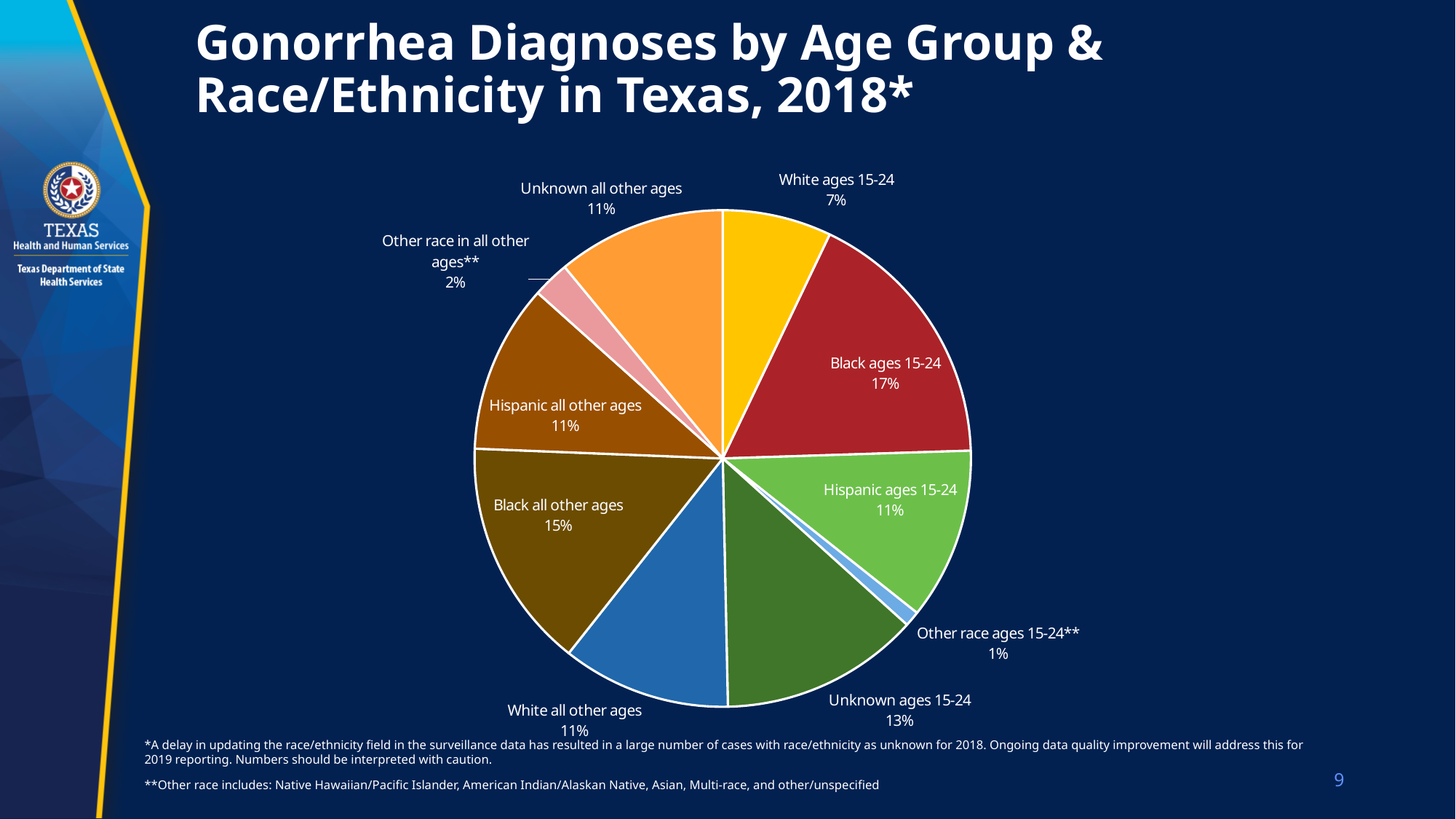
What is the title of the chart on the slide? Gonorrhea Diagnoses by Age Group & Race/Ethnicity in Texas, 2018* Which category has the smallest share of the pie? Other race ages 15-24 Which category has the largest share of the pie? Black ages 15-24 What percentage is shown for Unknown ages 15-24? 13% How many slices does the pie chart have? 10 What percentage is shown for Other race in all other ages? 2% What percentage is shown for Black all other ages? 15% What percentage of gonorrhea diagnoses is shown for Black ages 15-24? 17% What is the combined share of Hispanic ages 15-24 and Hispanic all other ages? 22% What is the difference in percentage points between Black ages 15-24 and White ages 15-24? 10 What kind of chart is shown on the slide? Pie chart Which is larger, the share for Black all other ages or the share for Unknown ages 15-24? Black all other ages